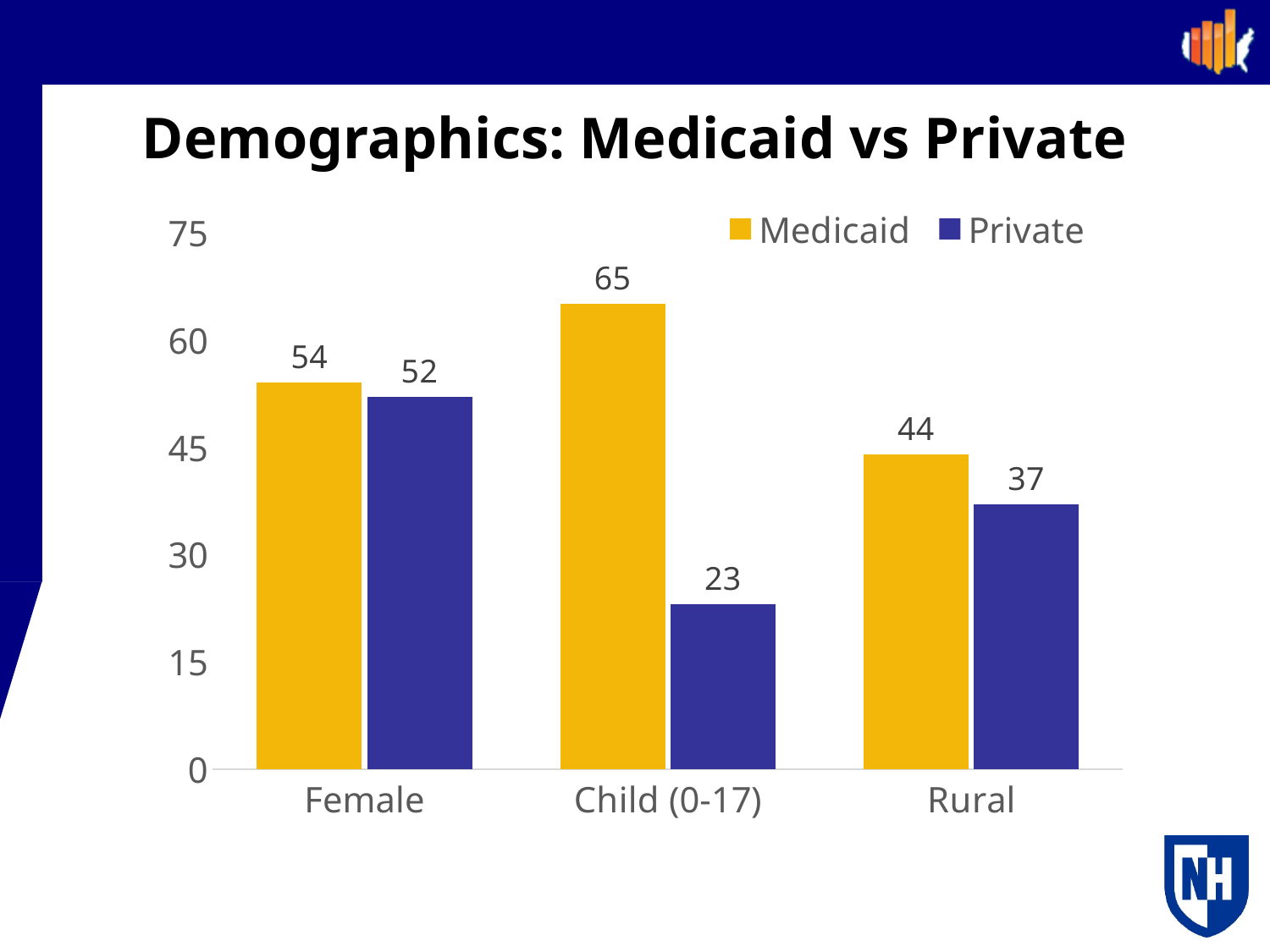
What is the Private value for Rural? 37 What is the difference between the Medicaid and Private values for Child (0-17)? 42 Which category has the highest Medicaid value? Child (0-17) What is the Medicaid value for Female? 54 What kind of chart is shown on the slide? Bar chart How many categories are shown on the x axis? 3 How many series does the legend list? 2 Which category has the lowest Private value? Child (0-17) What colour are the Medicaid bars? Yellow What is the difference between the Medicaid values for Female and Rural? 10 What is the Private value for Child (0-17)? 23 Which is larger, the Medicaid value for Rural or the Private value for Female? Private value for Female